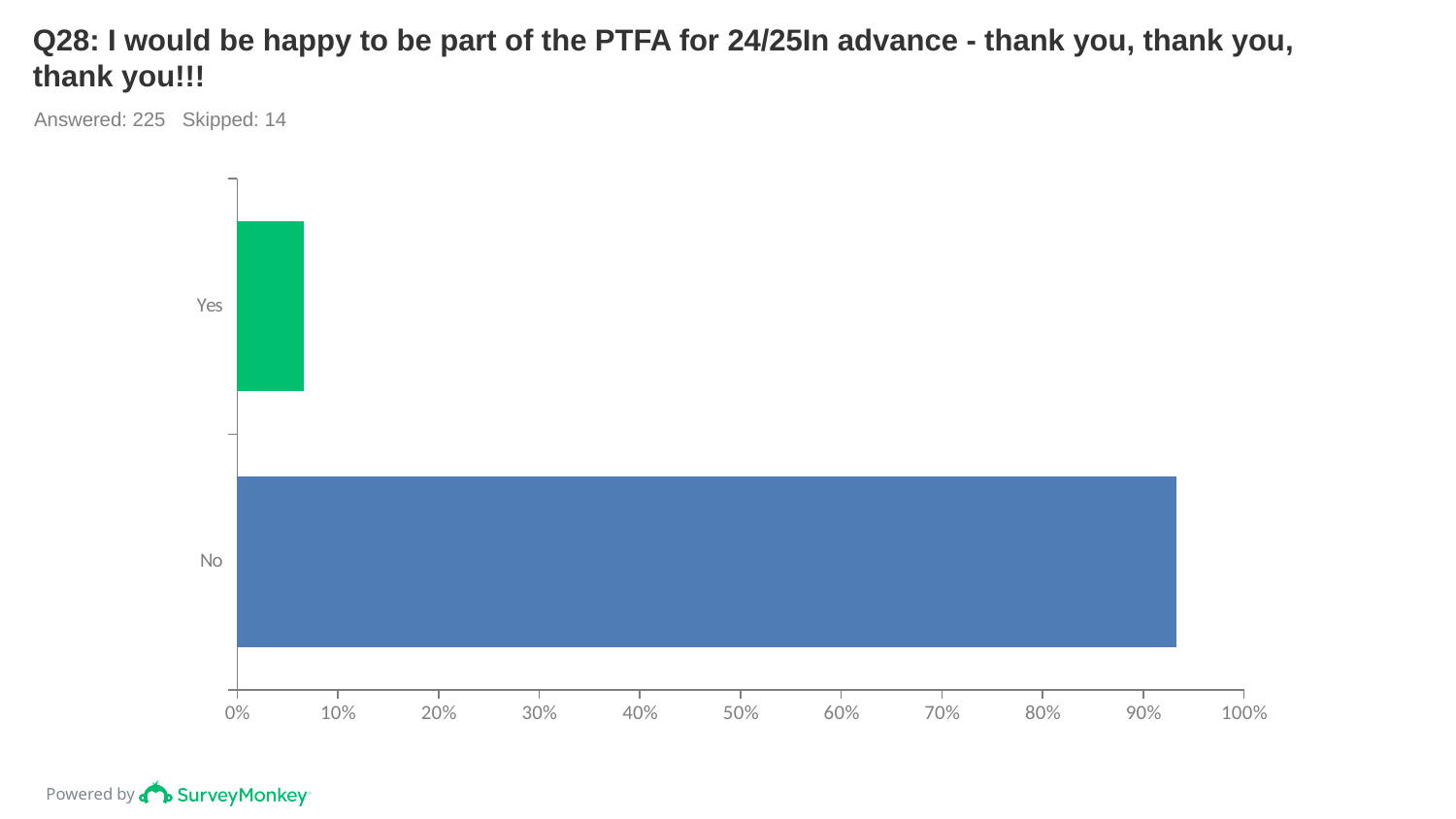
How many categories are plotted in the chart? 2 Which is larger, the value for Yes or the value for No? No What kind of chart is shown on the slide? bar chart Which category has the lowest value? Yes Is the value for No greater or less than 90%? greater How many respondents answered this question? 225 Is the value for Yes greater or less than 10%? less How many respondents skipped this question? 14 Is the value for No greater or less than 100%? less Which category has the highest value? No